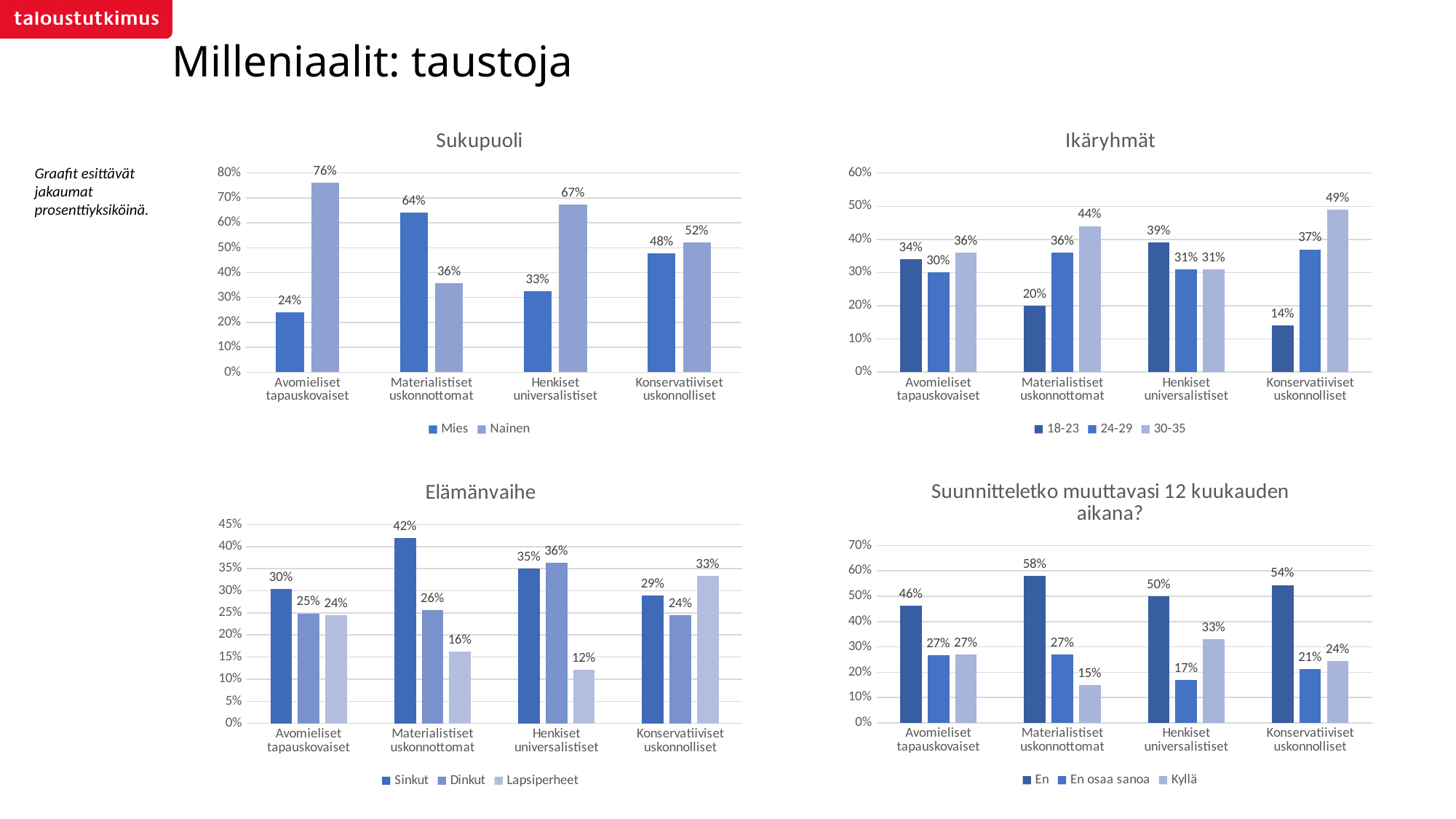
In the "Elämänvaihe" chart, how many categories are shown on the x axis? 4 In the "Ikäryhmät" chart, which is larger for Henkiset universalistiset: 18-23 or 24-29? 18-23 In the "Elämänvaihe" chart, what is the value for Lapsiperheet in the Henkiset universalistiset category? 12% What type of chart is the "Suunnitteletko muuttavasi 12 kuukauden aikana?" chart? Bar chart In the "Suunnitteletko muuttavasi 12 kuukauden aikana?" chart, what is the value for En in the Materialistiset uskonnottomat category? 58% In the "Elämänvaihe" chart, which category has the lowest value for Sinkut? Konservatiiviset uskonnolliset In the "Suunnitteletko muuttavasi 12 kuukauden aikana?" chart, what is the difference between Kyllä and En osaa sanoa for Henkiset universalistiset? 16% In the "Ikäryhmät" chart, which category has the highest value for the 30-35 series? Konservatiiviset uskonnolliset In the "Sukupuoli" chart, what is the value for Nainen in the Avomieliset tapauskovaiset category? 76% In the "Sukupuoli" chart, how many series does the legend list? 2 In the "Ikäryhmät" chart, what is the value for 18-23 in the Konservatiiviset uskonnolliset category? 14% In the "Sukupuoli" chart, what is the difference between Mies and Nainen for Materialistiset uskonnottomat? 28%